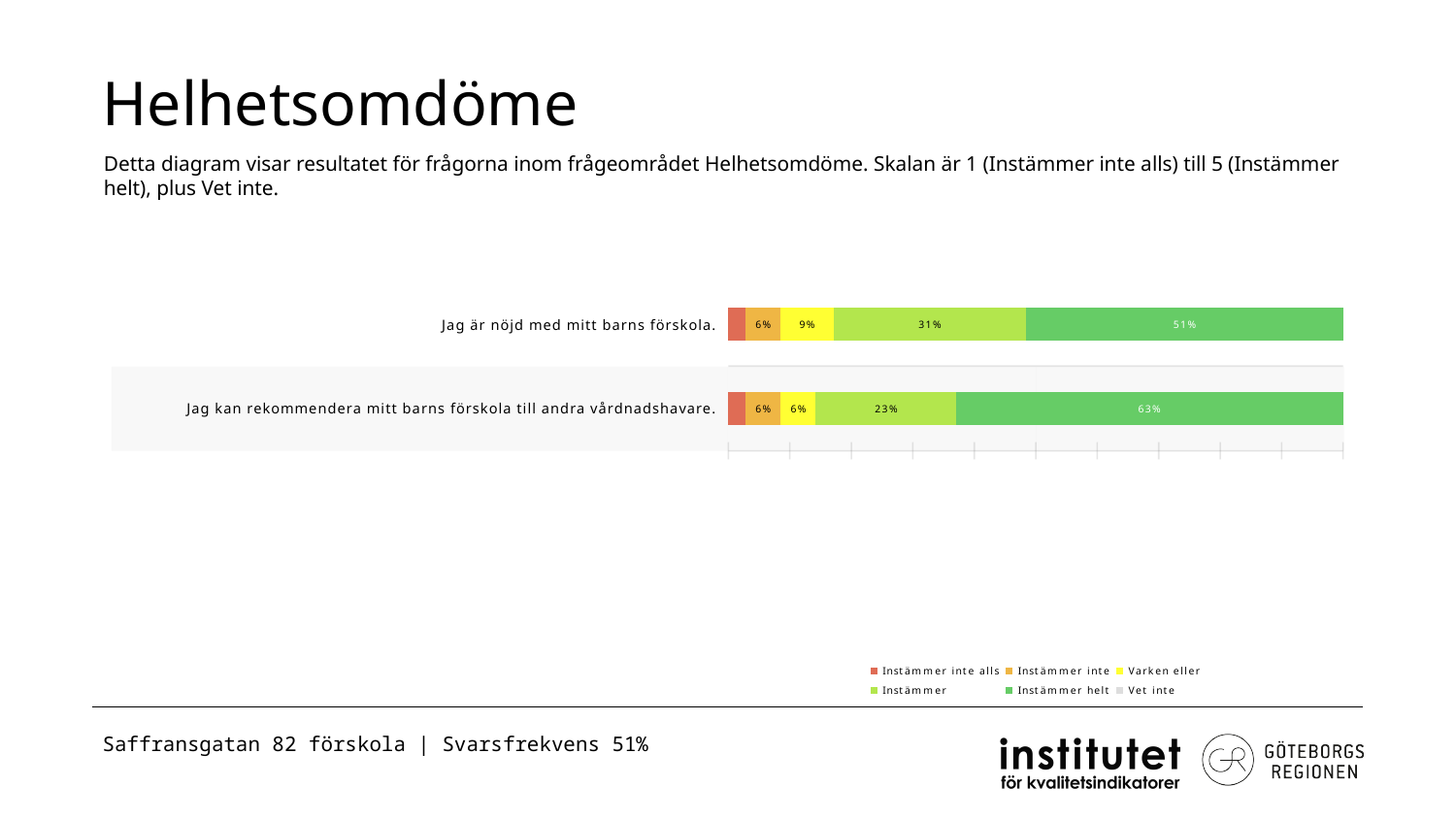
What share answered 'Varken eller' for 'Jag kan rekommendera mitt barns förskola till andra vårdnadshavare.'? 6% Which question has the larger 'Instämmer helt' share? Jag kan rekommendera mitt barns förskola till andra vårdnadshavare. How many questions (categories) are plotted in the chart? 2 What share answered 'Instämmer helt' for 'Jag kan rekommendera mitt barns förskola till andra vårdnadshavare.'? 63% How many series does the legend list? 6 What share answered 'Instämmer inte' for 'Jag är nöjd med mitt barns förskola.'? 6% What share answered 'Instämmer helt' for 'Jag är nöjd med mitt barns förskola.'? 51% What share answered 'Instämmer' for 'Jag är nöjd med mitt barns förskola.'? 31% What kind of chart is shown on the slide? Stacked bar chart For 'Jag är nöjd med mitt barns förskola.', which response option has the largest share? Instämmer helt What is the difference in the 'Instämmer helt' share between 'Jag kan rekommendera mitt barns förskola till andra vårdnadshavare.' and 'Jag är nöjd med mitt barns förskola.'? 12 percentage points What is the difference in the 'Instämmer' share between 'Jag är nöjd med mitt barns förskola.' and 'Jag kan rekommendera mitt barns förskola till andra vårdnadshavare.'? 8 percentage points